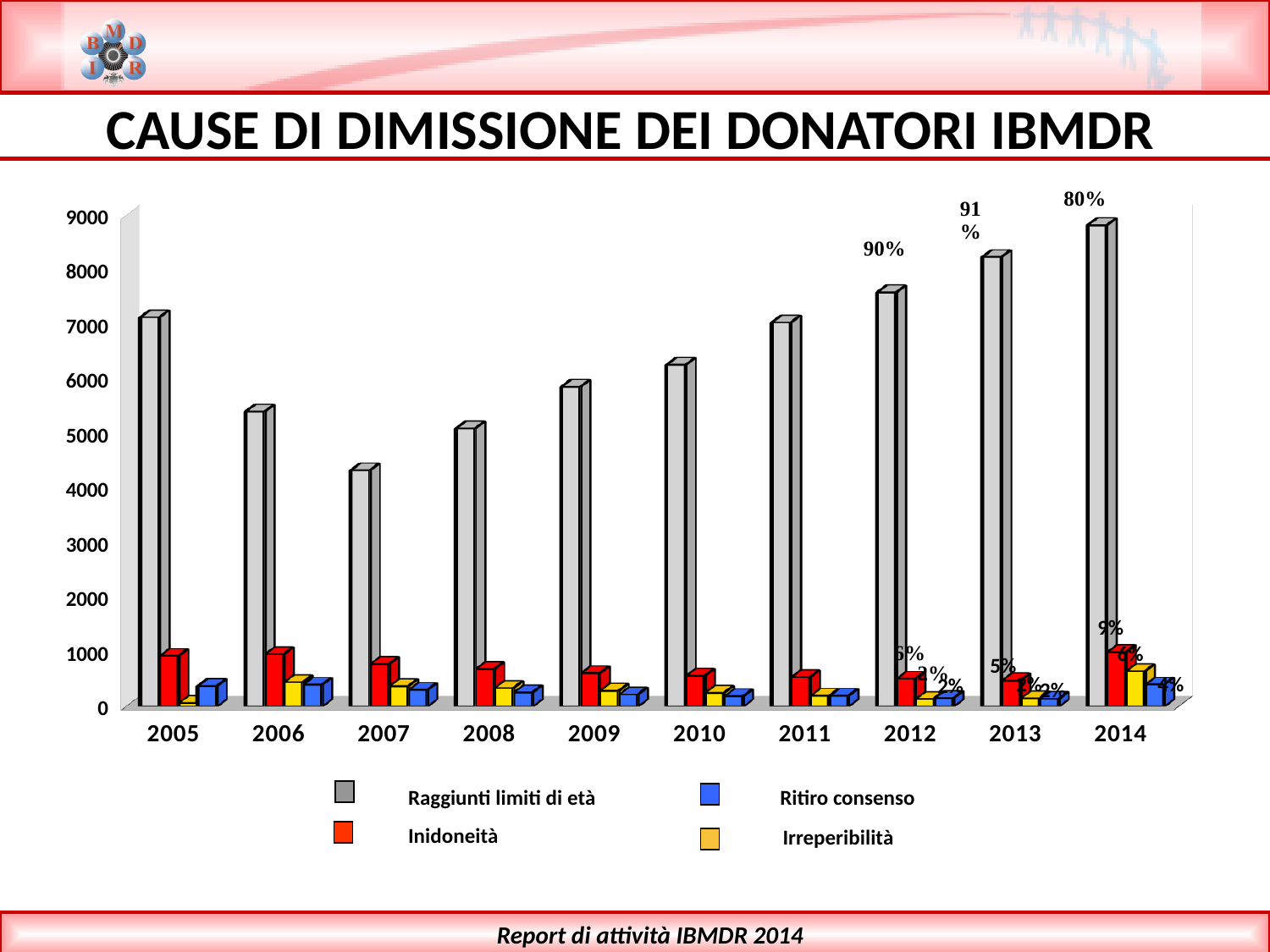
How many years are shown on the x axis? 10 How many series does the legend list? 4 In which year is the Raggiunti limiti di età bar the highest? 2014 Is the Raggiunti limiti di età value for 2014 greater or less than 8000? greater What kind of chart is shown on the slide? bar chart Is the Raggiunti limiti di età value for 2005 greater or less than 7000? greater Is the Raggiunti limiti di età value for 2007 greater or less than 5000? less In which year is the Raggiunti limiti di età bar the lowest? 2007 Which series is shown in red in the legend? Inidoneità Do the Raggiunti limiti di età values rise or fall from 2007 to 2014? rise Which is larger, the Raggiunti limiti di età value for 2005 or for 2006? 2005 What percentage label is shown above the Raggiunti limiti di età bar for 2012? 90%